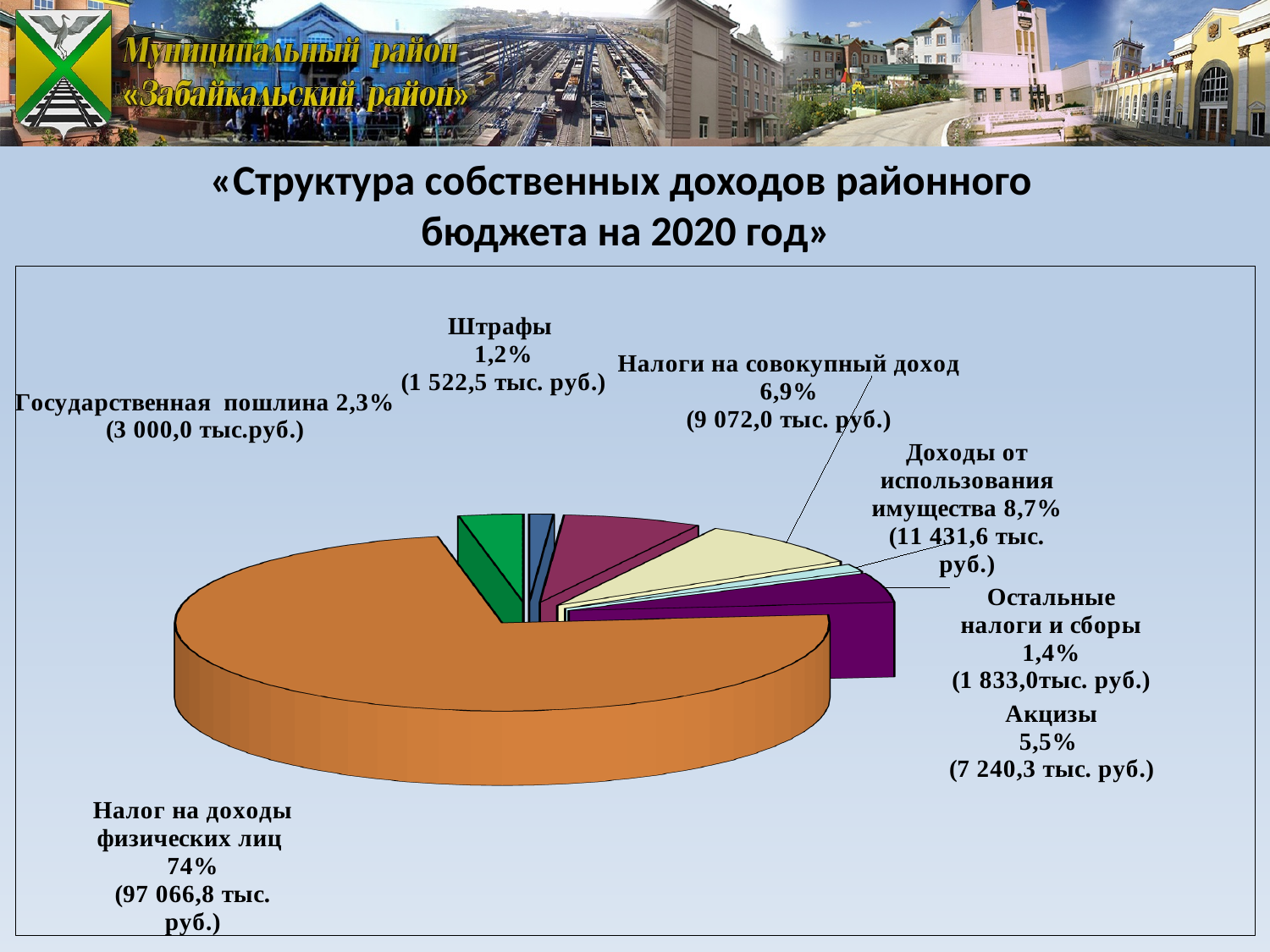
What is the title of the chart on the slide? «Структура собственных доходов районного бюджета на 2020 год» Which has a larger share: «Налоги на совокупный доход» or «Акцизы»? Налоги на совокупный доход What percentage is shown for «Акцизы»? 5,5% What amount in тыс. руб. is shown for «Доходы от использования имущества»? 11 431,6 тыс. руб. Which category has the smallest share of the pie? Штрафы What share of the pie does «Налог на доходы физических лиц» have? 74% Which category has the largest share of the pie? Налог на доходы физических лиц How many categories (slices) does the pie chart show? 7 What kind of chart is shown on the slide? pie chart What percentage is shown for «Остальные налоги и сборы»? 1,4% What amount in тыс. руб. is shown for «Штрафы»? 1 522,5 тыс. руб. What is the difference in percentage points between «Доходы от использования имущества» and «Налоги на совокупный доход»? 1,8